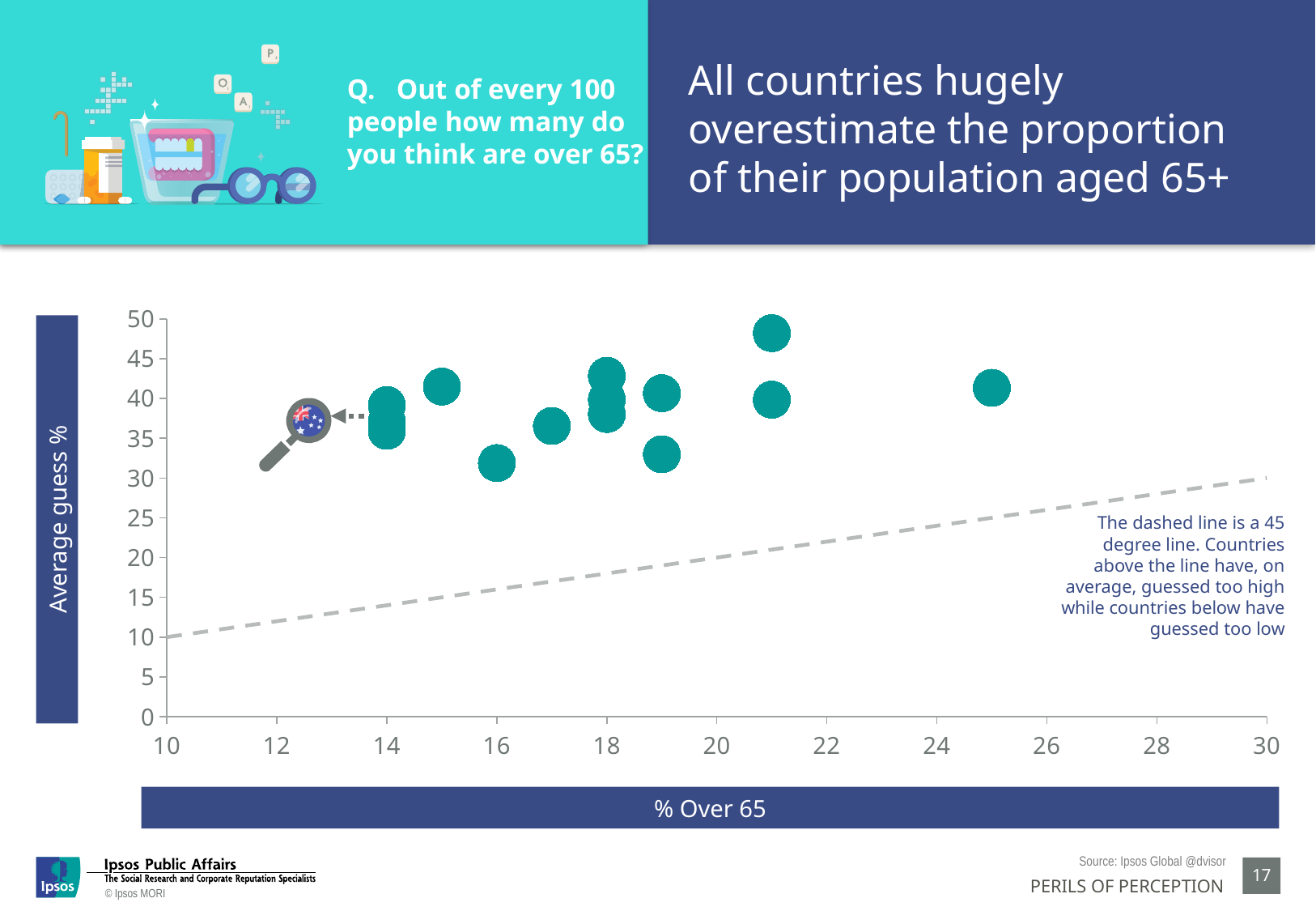
What is the title of the horizontal axis? % Over 65 Is the average guess for the point at 16% over 65 greater or less than 35? less What kind of chart is shown on the slide? Scatter chart Are the plotted countries above or below the dashed 45 degree line? Above What is the title of the vertical axis? Average guess % What is the maximum value shown on the vertical axis? 50 Is the average guess for the point at 25% over 65 greater or less than 30? greater Is the average guess for the point at 15% over 65 greater or less than 40? greater Which has the higher average guess: the point at 25% over 65 or the point at 16% over 65? The point at 25% over 65